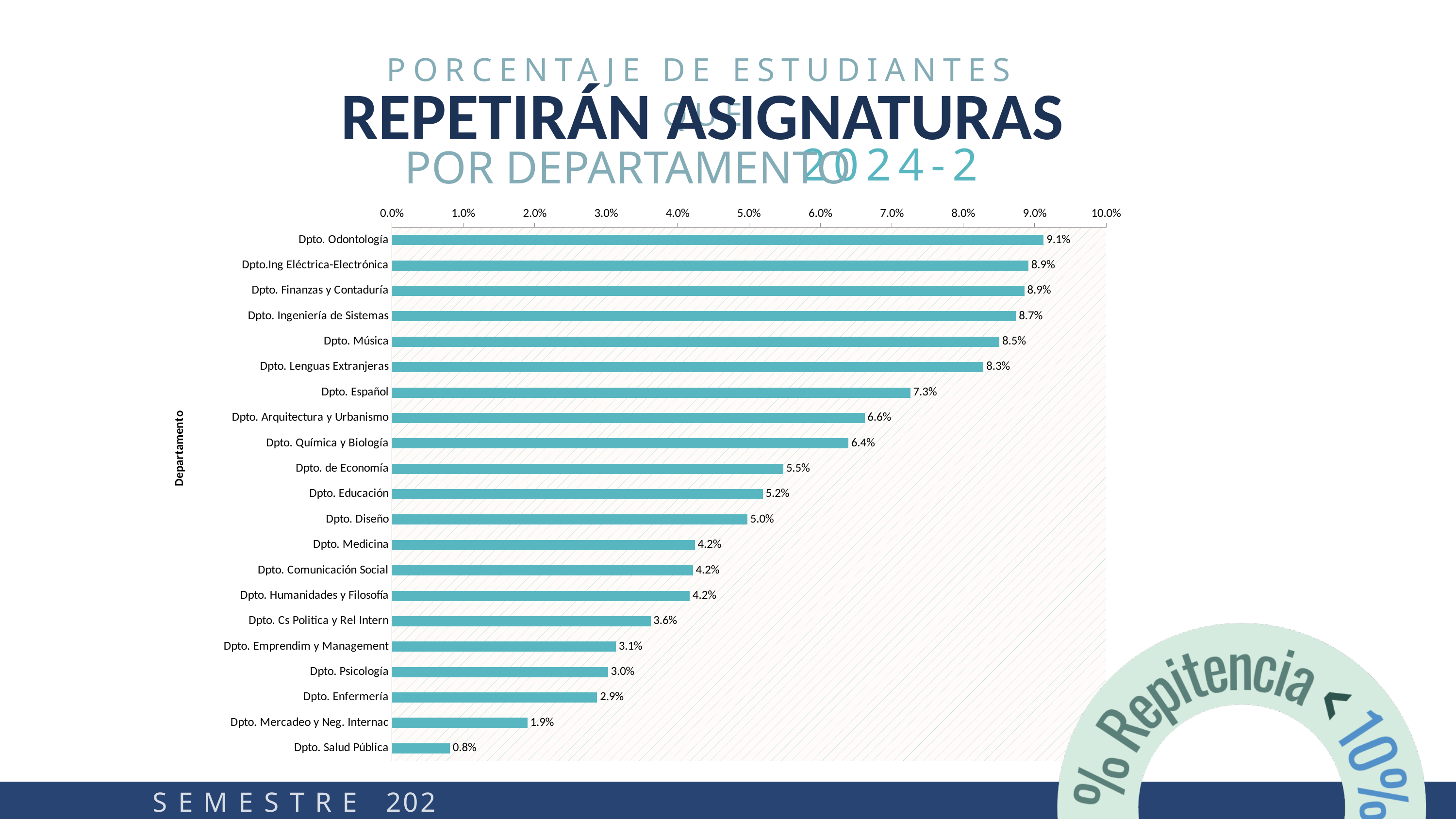
Which is larger, the value for Dpto. Educación or the value for Dpto. Medicina? Dpto. Educación What is the value for Dpto. Mercadeo y Neg. Internac? 1.9% What kind of chart is shown on the slide? Bar chart What is the difference between the values for Dpto. Música and Dpto. Diseño? 3.5% What is the value for Dpto. Odontología? 9.1% What is the difference between the values for Dpto. Odontología and Dpto. Salud Pública? 8.3% What is the value for Dpto. Español? 7.3% Which department has the highest value? Dpto. Odontología What is the value for Dpto. Psicología? 3.0% Which department has the lowest value? Dpto. Salud Pública What is the label of the vertical axis? Departamento How many departments are shown in the chart? 21